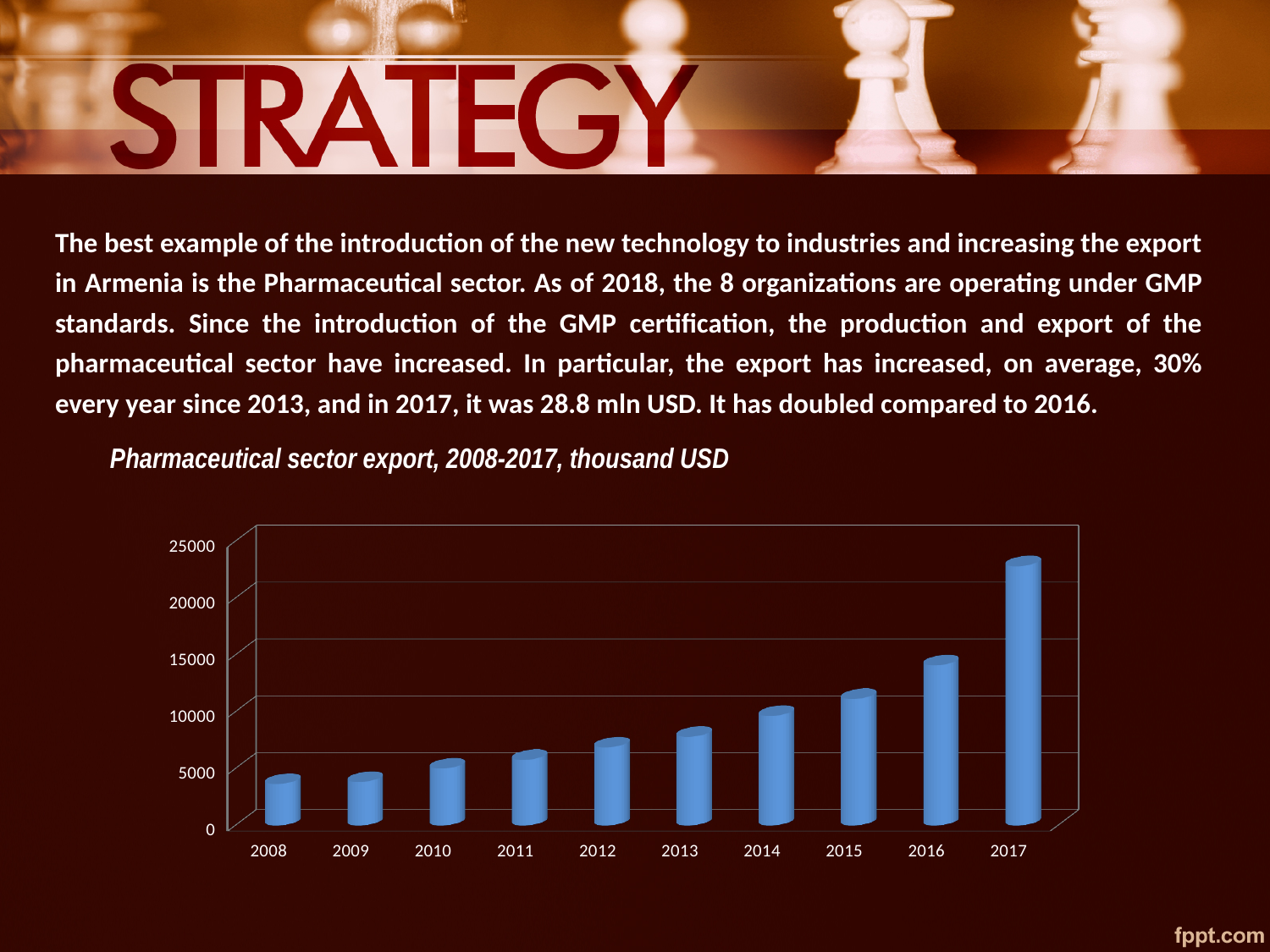
Which year has the larger value, 2016 or 2017? 2017 Which year has the highest pharmaceutical sector export in the chart? 2017 Is the value for 2016 greater or less than 10000? greater Which year has the larger value, 2012 or 2014? 2014 How many years are plotted on the x axis of the chart? 10 Is the value for 2015 greater or less than 15000? less Is the value for 2008 greater or less than 5000? less What kind of chart is shown on the slide? bar chart What is the title of the chart? Pharmaceutical sector export, 2008-2017, thousand USD Do the values in the chart generally rise or fall from 2008 to 2017? rise